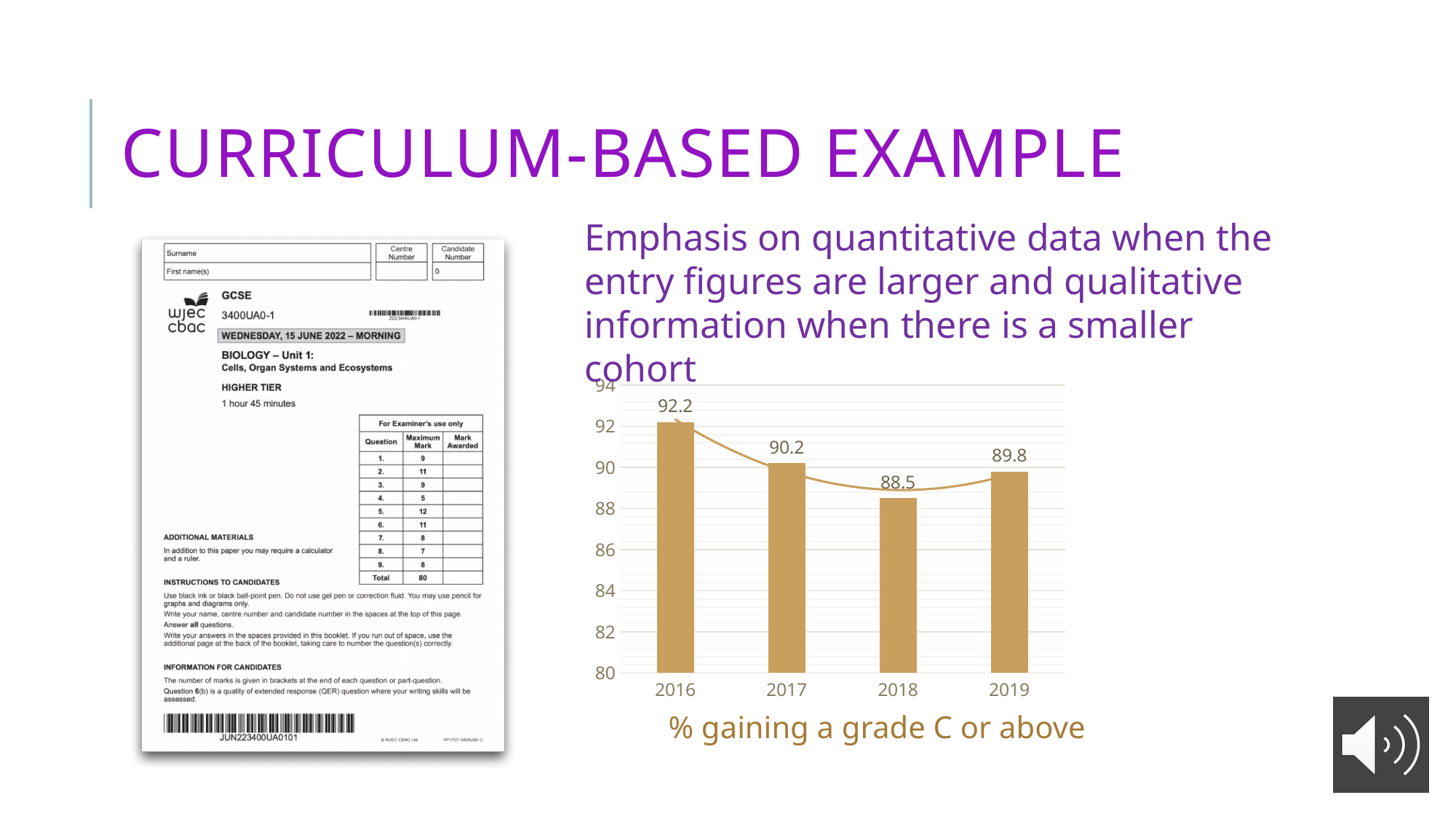
What is the value for 2018 in the chart? 88.5 What is the difference between the values for 2016 and 2018? 3.7 What is the value for 2016 in the chart? 92.2 How many years are shown on the x axis of the chart? 4 What kind of chart is shown on the slide? bar chart What is the label shown beneath the chart? % gaining a grade C or above What is the difference between the values for 2017 and 2019? 0.4 Which year has the highest value in the chart? 2016 Which is larger, the value for 2017 or the value for 2019? 2017 Is the value for 2018 greater or less than 90? less What is the value for 2019 in the chart? 89.8 Which year has the lowest value in the chart? 2018